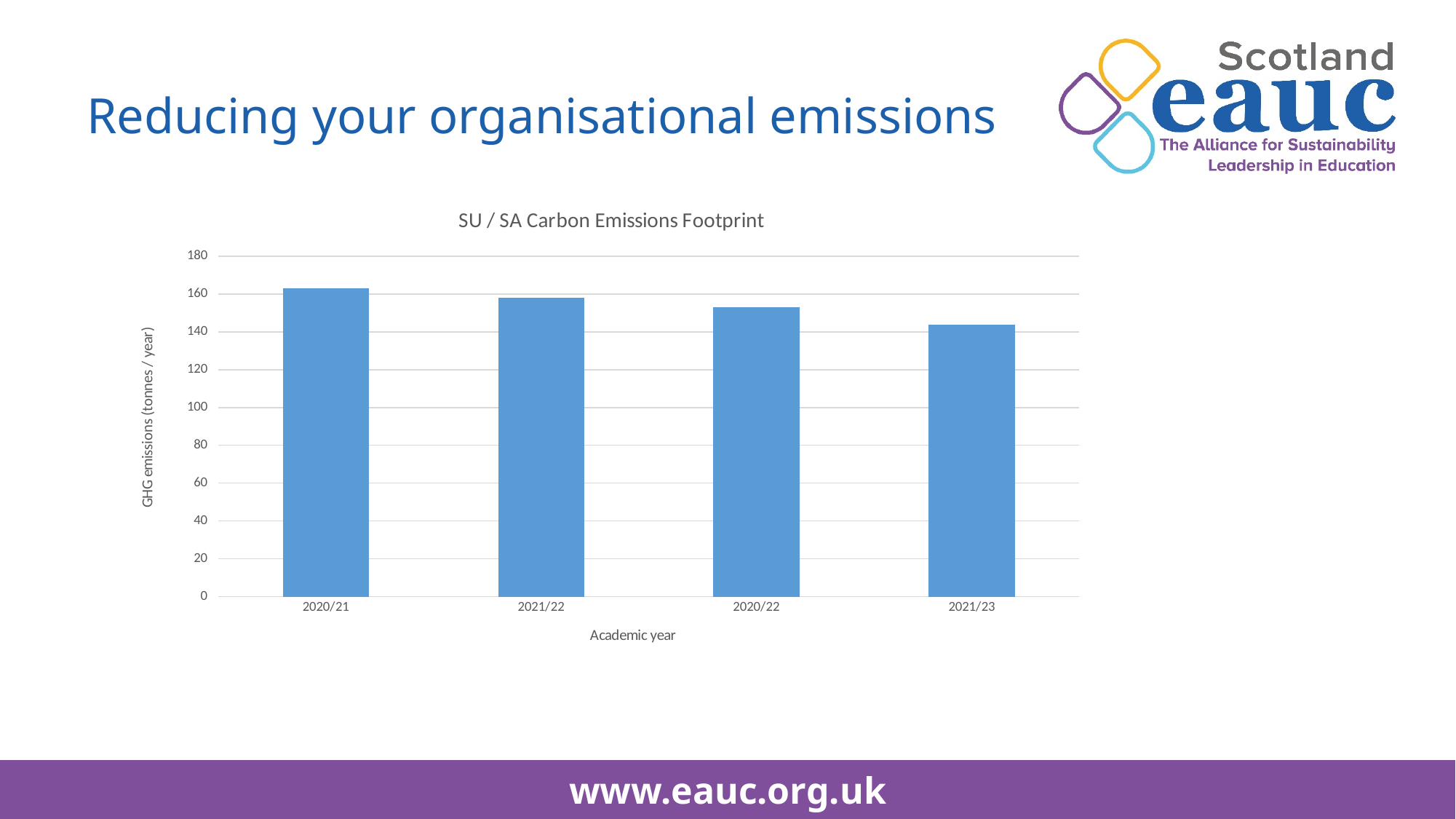
How many academic years are plotted on the chart? 4 Is the value for 2020/22 greater or less than 160? less What is the label on the vertical axis of the chart? GHG emissions (tonnes / year) Do the GHG emissions rise or fall across the academic years from left to right? fall Which academic year has the lowest GHG emissions? 2021/23 Which has higher GHG emissions, 2021/22 or 2021/23? 2021/22 Which academic year has the highest GHG emissions? 2020/21 Is the value for 2021/22 greater or less than 140? greater What is the title of the chart? SU / SA Carbon Emissions Footprint What kind of chart is shown on the slide? bar chart Is the value for 2021/23 greater or less than 160? less